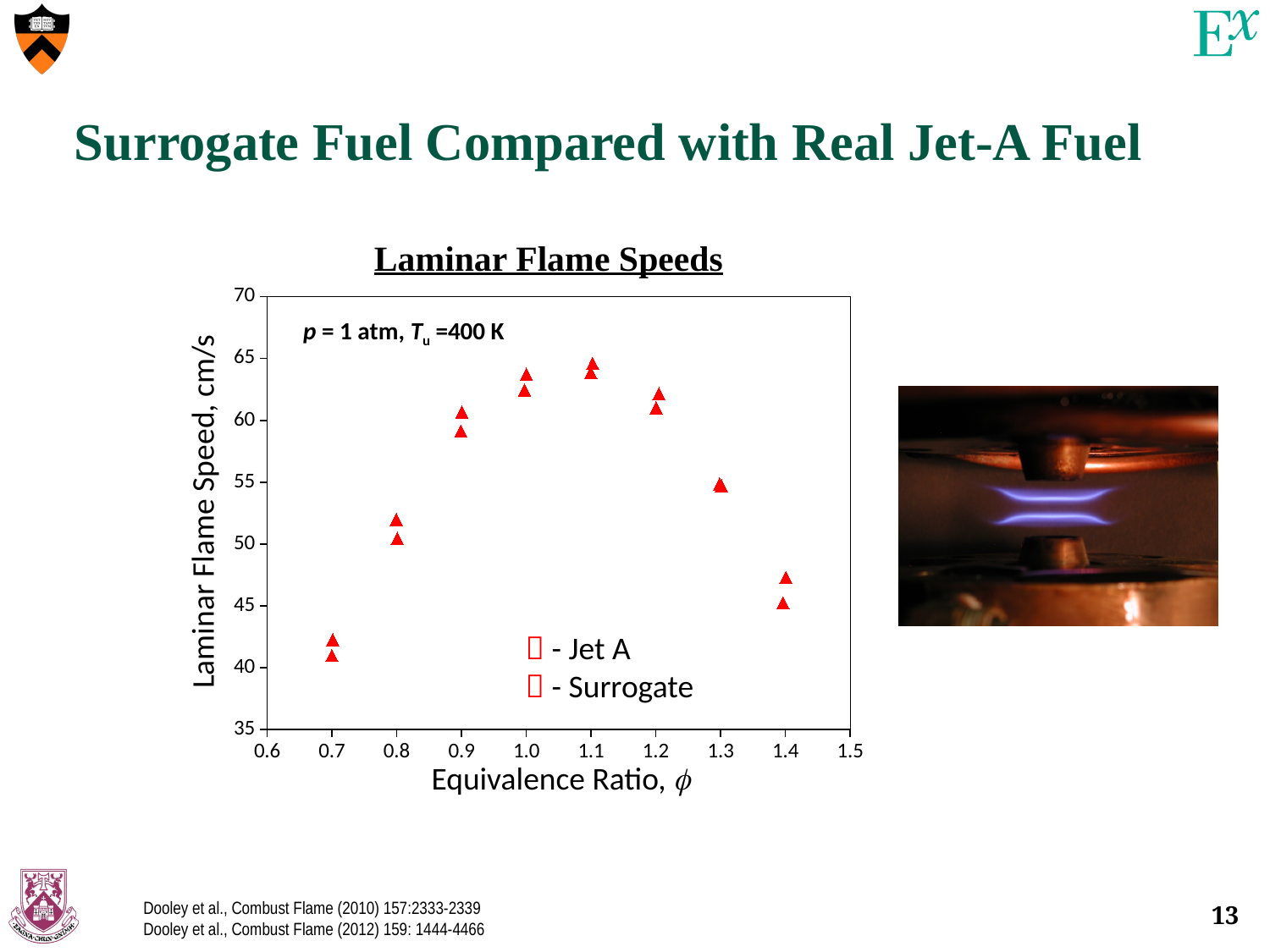
What kind of chart is shown under the title "Laminar Flame Speeds"? scatter plot At which equivalence ratio are the laminar flame speeds highest? 1.1 What pressure and unburned temperature are stated on the Laminar Flame Speeds chart? p = 1 atm, Tu = 400 K At how many equivalence ratios are data points plotted in the Laminar Flame Speeds chart? 8 What is the label of the x axis of the Laminar Flame Speeds chart? Equivalence Ratio, φ Are the laminar flame speeds at an equivalence ratio of 0.7 greater or less than 45 cm/s? less Do the laminar flame speeds rise or fall as the equivalence ratio increases from 1.1 to 1.4? fall Are the laminar flame speeds at an equivalence ratio of 1.1 greater or less than 60 cm/s? greater Are the laminar flame speeds at an equivalence ratio of 1.4 greater or less than 50 cm/s? less At which equivalence ratio are the laminar flame speeds lowest? 0.7 How many series does the legend of the Laminar Flame Speeds chart list? 2 Which has the higher laminar flame speed: equivalence ratio 1.0 or equivalence ratio 1.3? 1.0